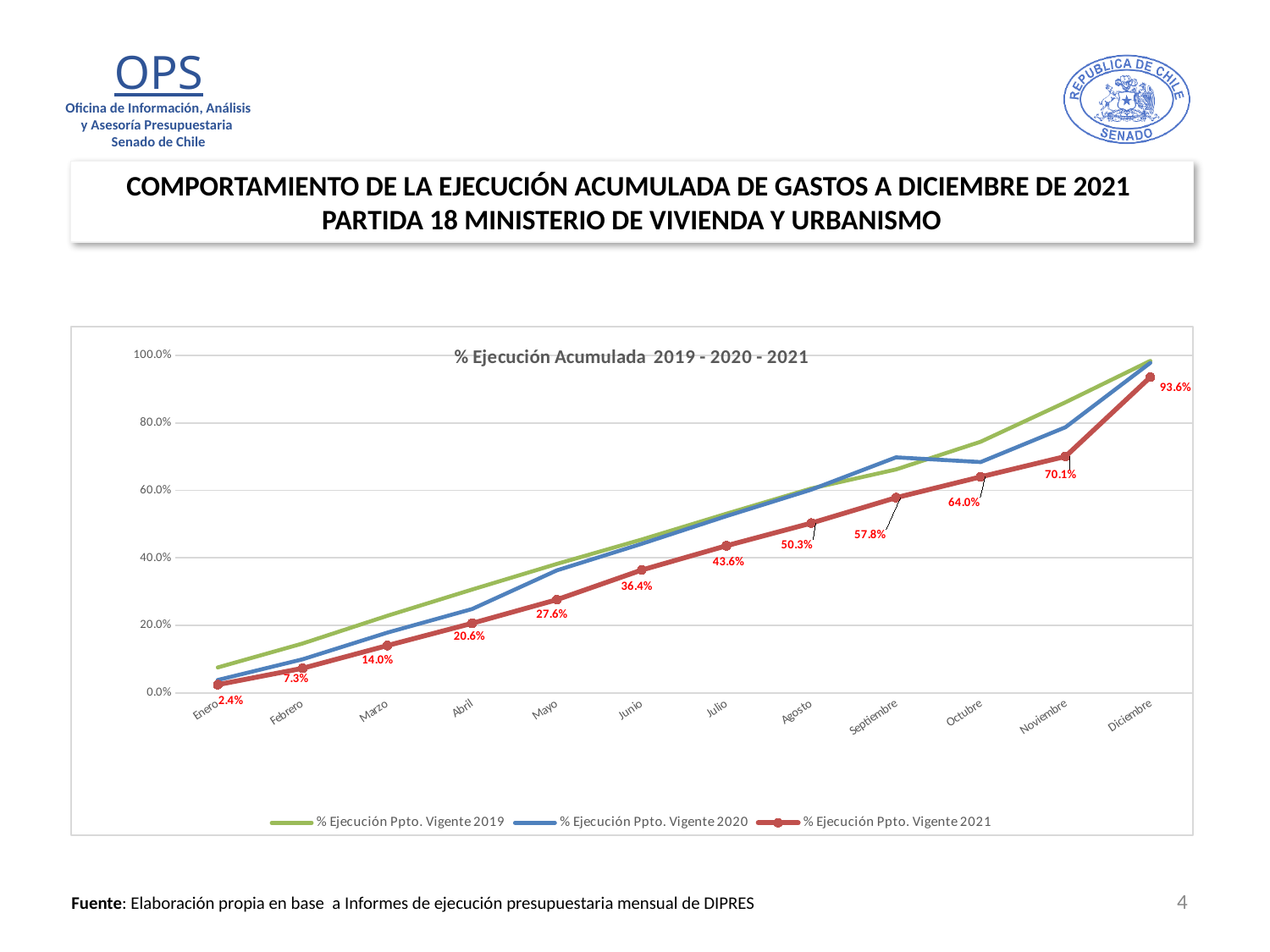
Is the value for % Ejecución Ppto. Vigente 2020 in Septiembre greater or less than 60.0%? greater What is the value for % Ejecución Ppto. Vigente 2021 in Junio? 36.4% How many series does the legend list? 3 In Marzo, which series has the higher value: % Ejecución Ppto. Vigente 2019 or % Ejecución Ppto. Vigente 2021? % Ejecución Ppto. Vigente 2019 What is the value for % Ejecución Ppto. Vigente 2021 in Octubre? 64.0% Does the % Ejecución Ppto. Vigente 2021 series rise or fall from Enero to Diciembre? rise How many months are shown on the x axis? 12 What type of chart is shown on the slide? line chart What is the value for % Ejecución Ppto. Vigente 2021 in Diciembre? 93.6% What is the difference between the % Ejecución Ppto. Vigente 2021 values for Diciembre and Noviembre? 23.5% What is the value for % Ejecución Ppto. Vigente 2021 in Enero? 2.4% What is the title of the chart? % Ejecución Acumulada 2019 - 2020 - 2021